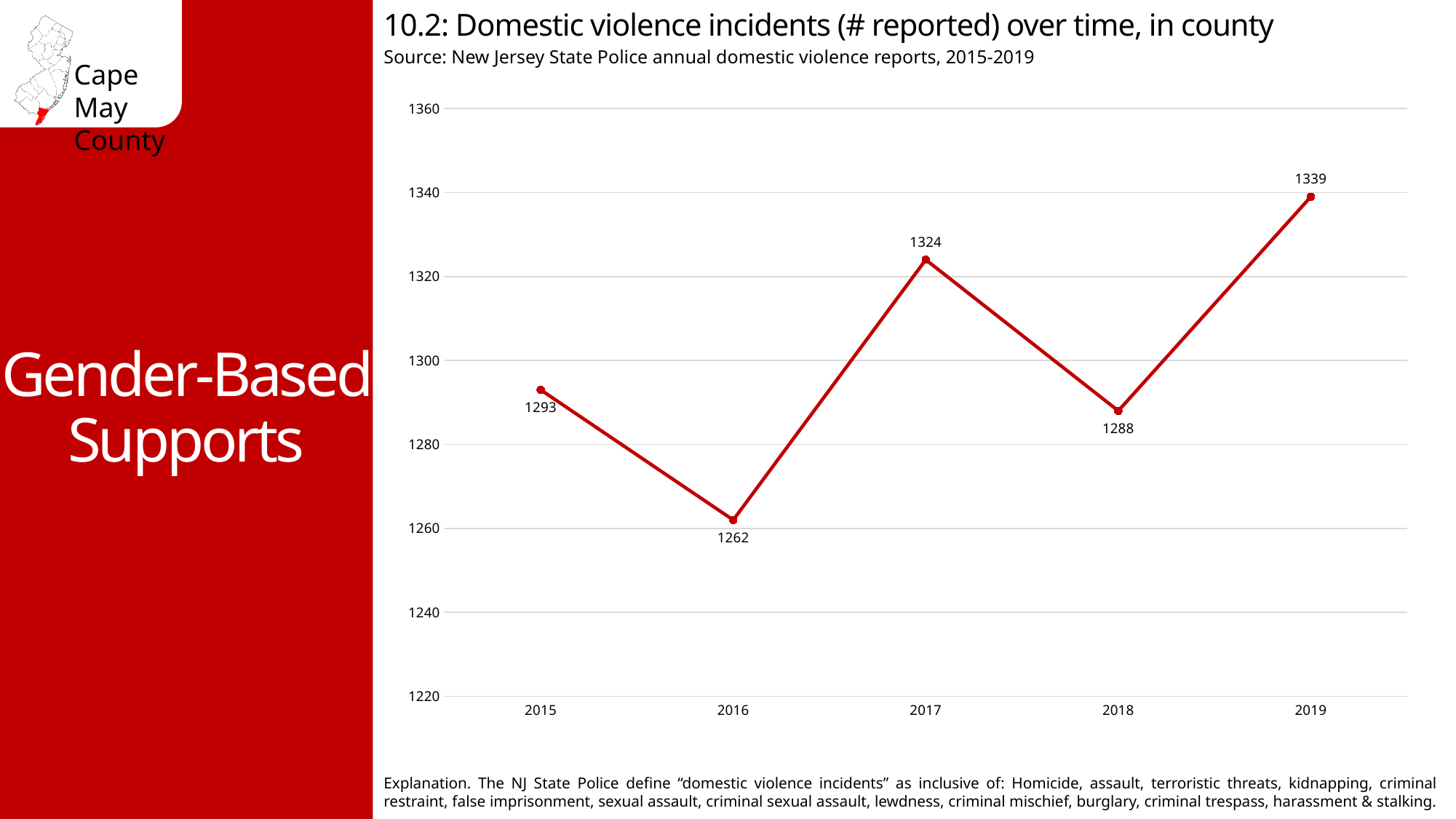
Did the number of reported incidents rise or fall from 2018 to 2019? rise How many domestic violence incidents were reported in 2017? 1324 How many domestic violence incidents were reported in 2016? 1262 What type of chart is shown on the slide? line chart Which year had more reported incidents, 2015 or 2018? 2015 Is the value for 2017 greater or less than 1300? greater Which year had the highest number of reported domestic violence incidents? 2019 How many domestic violence incidents were reported in 2019? 1339 How many years are plotted on the chart? 5 Which year had the lowest number of reported domestic violence incidents? 2016 What is the difference between the number of incidents reported in 2019 and in 2018? 51 What is the difference between the number of incidents reported in 2015 and in 2016? 31